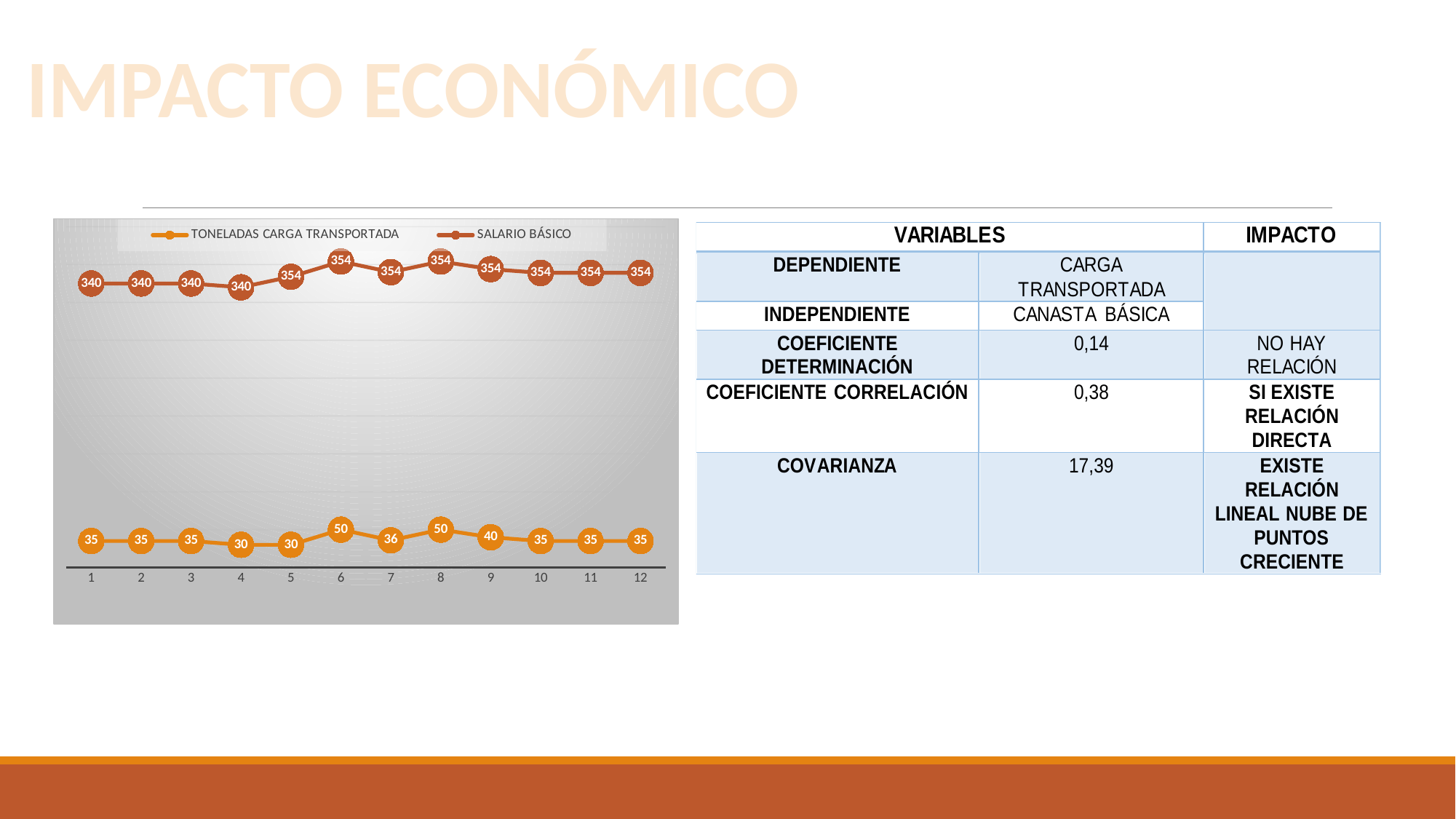
What is the value of SALARIO BÁSICO at point 1? 340 Does SALARIO BÁSICO rise or fall from point 1 to point 12? rise What is the lowest value of TONELADAS CARGA TRANSPORTADA? 30 What is the value of SALARIO BÁSICO at point 12? 354 What is the difference between SALARIO BÁSICO at point 5 and at point 4? 14 How many series does the chart legend list? 2 How many points are plotted along the x axis for each series? 12 What is the value of TONELADAS CARGA TRANSPORTADA at point 9? 40 What kind of chart is shown on the slide? line chart Which is larger: TONELADAS CARGA TRANSPORTADA at point 7 or at point 8? point 8 What is the value of TONELADAS CARGA TRANSPORTADA at point 6? 50 At which point does TONELADAS CARGA TRANSPORTADA first reach its highest value? 6